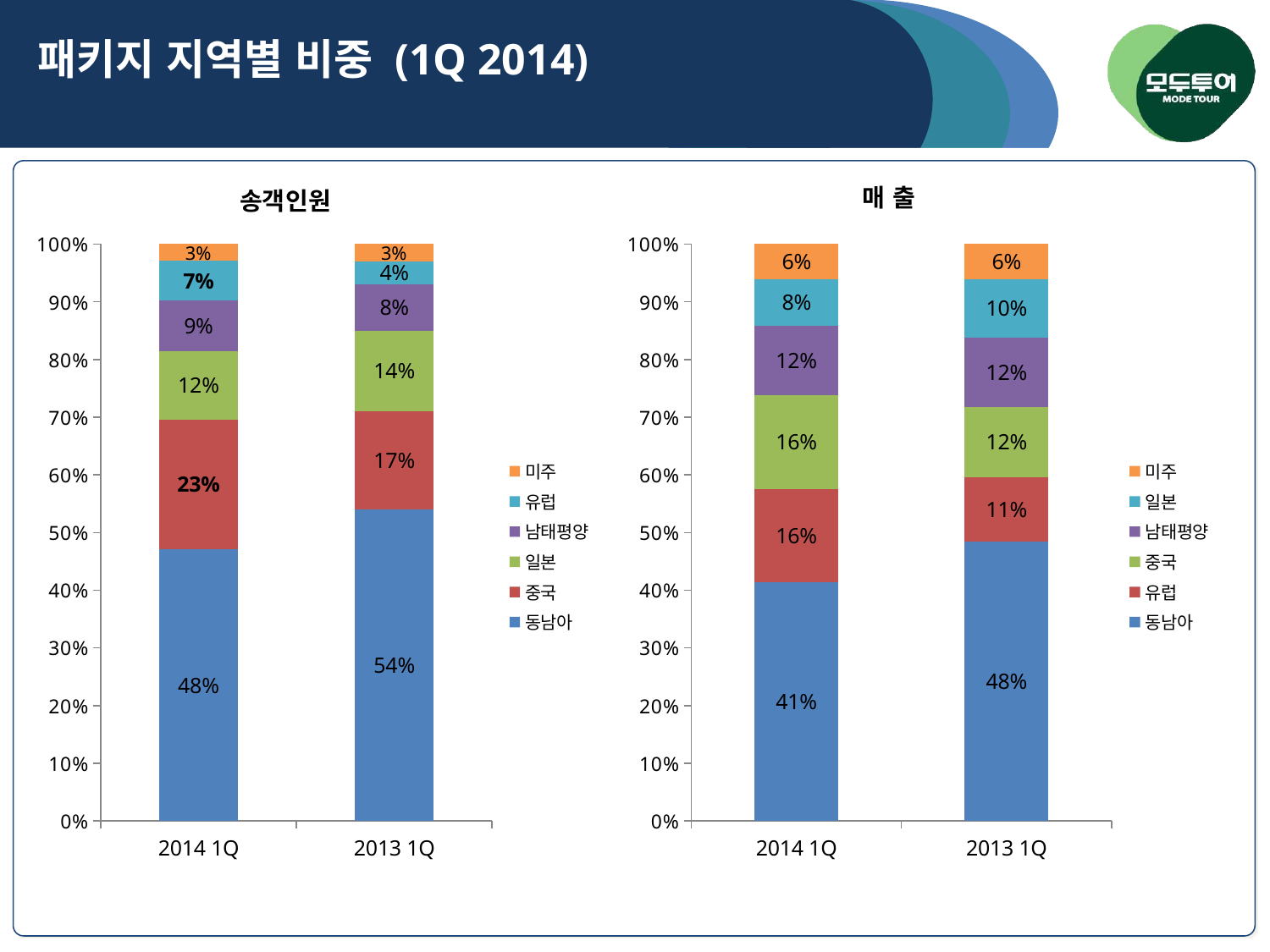
In the 송객인원 chart, what is the value for 동남아 in 2014 1Q? 48% How many series does the legend of the 매출 chart list? 6 How many categories are shown on the x axis of the 송객인원 chart? 2 In the 송객인원 chart, what is the difference between the 동남아 share in 2013 1Q and in 2014 1Q? 6% In the 매출 chart, what is the difference between the 유럽 share in 2014 1Q and in 2013 1Q? 5% In the 송객인원 chart, what is the value for 중국 in 2013 1Q? 17% In the 매출 chart, what is the value for 동남아 in 2013 1Q? 48% In the 송객인원 chart, which region has the largest share in 2014 1Q? 동남아 In the 매출 chart, what is the value for 일본 in 2014 1Q? 8% In the 매출 chart, which region has the smallest share in 2013 1Q? 미주 What kind of chart is the 매출 chart? Stacked bar chart In the 송객인원 chart, is the 중국 share larger in 2014 1Q or in 2013 1Q? 2014 1Q